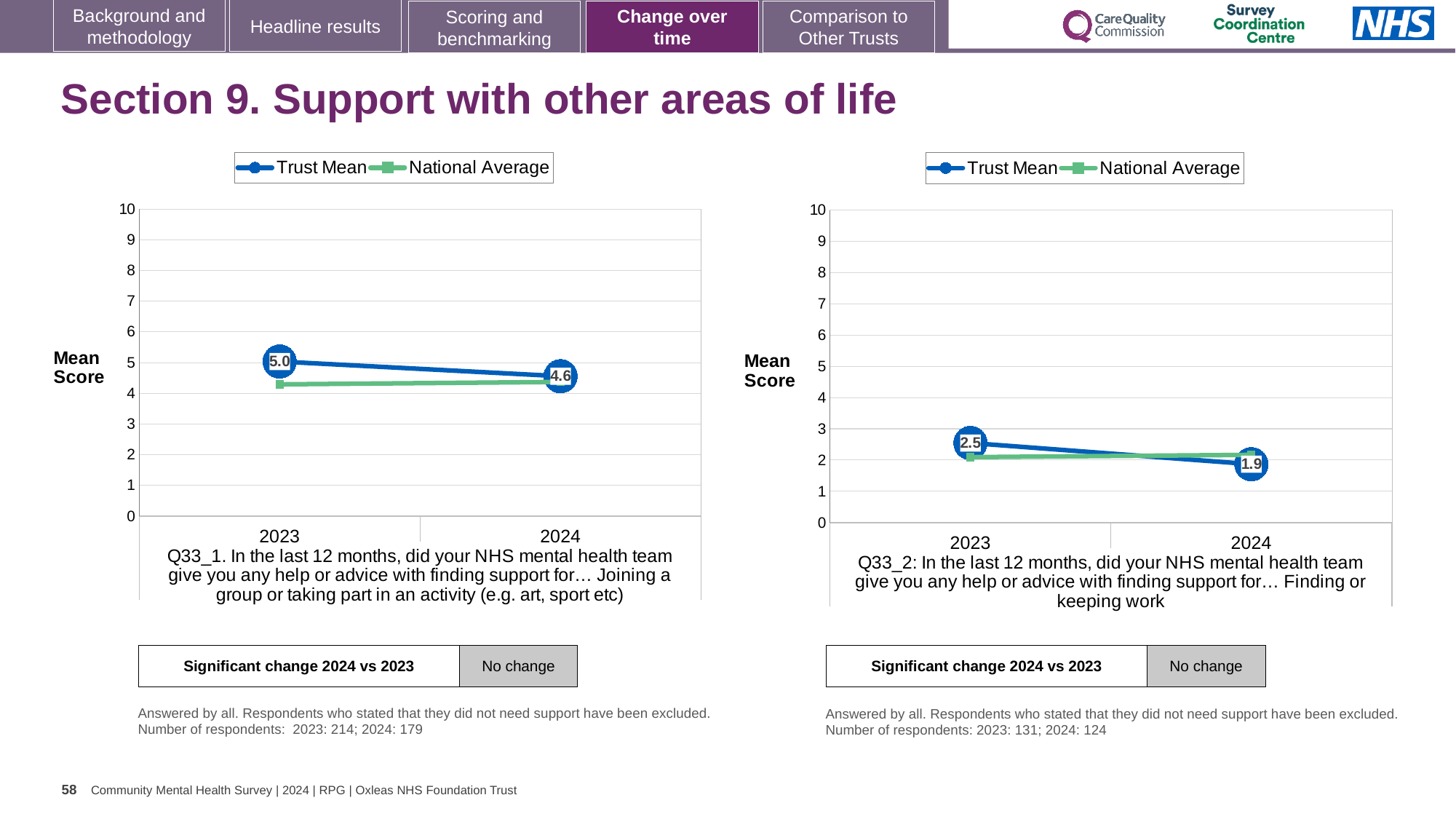
On the right chart (Q33_2), does the Trust Mean rise or fall from 2023 to 2024? fall On the right chart (Q33_2), is the National Average for 2024 greater or less than 3? less On the right chart (Q33_2), what is the Trust Mean score for 2023? 2.5 How many series does the legend of the left chart (Q33_1) list? 2 On the left chart (Q33_1), which year has the higher Trust Mean, 2023 or 2024? 2023 On the left chart (Q33_1), what is the Trust Mean score for 2024? 4.6 What type of chart is the right chart (Q33_2)? line chart On the right chart (Q33_2), what is the difference between the Trust Mean in 2023 and in 2024? 0.6 On the left chart (Q33_1), by how much did the Trust Mean change from 2023 to 2024? 0.4 On the left chart (Q33_1), is the National Average for 2023 greater or less than 5? less On the left chart (Q33_1), what is the Trust Mean score for 2023? 5.0 On the right chart (Q33_2), what is the Trust Mean score for 2024? 1.9